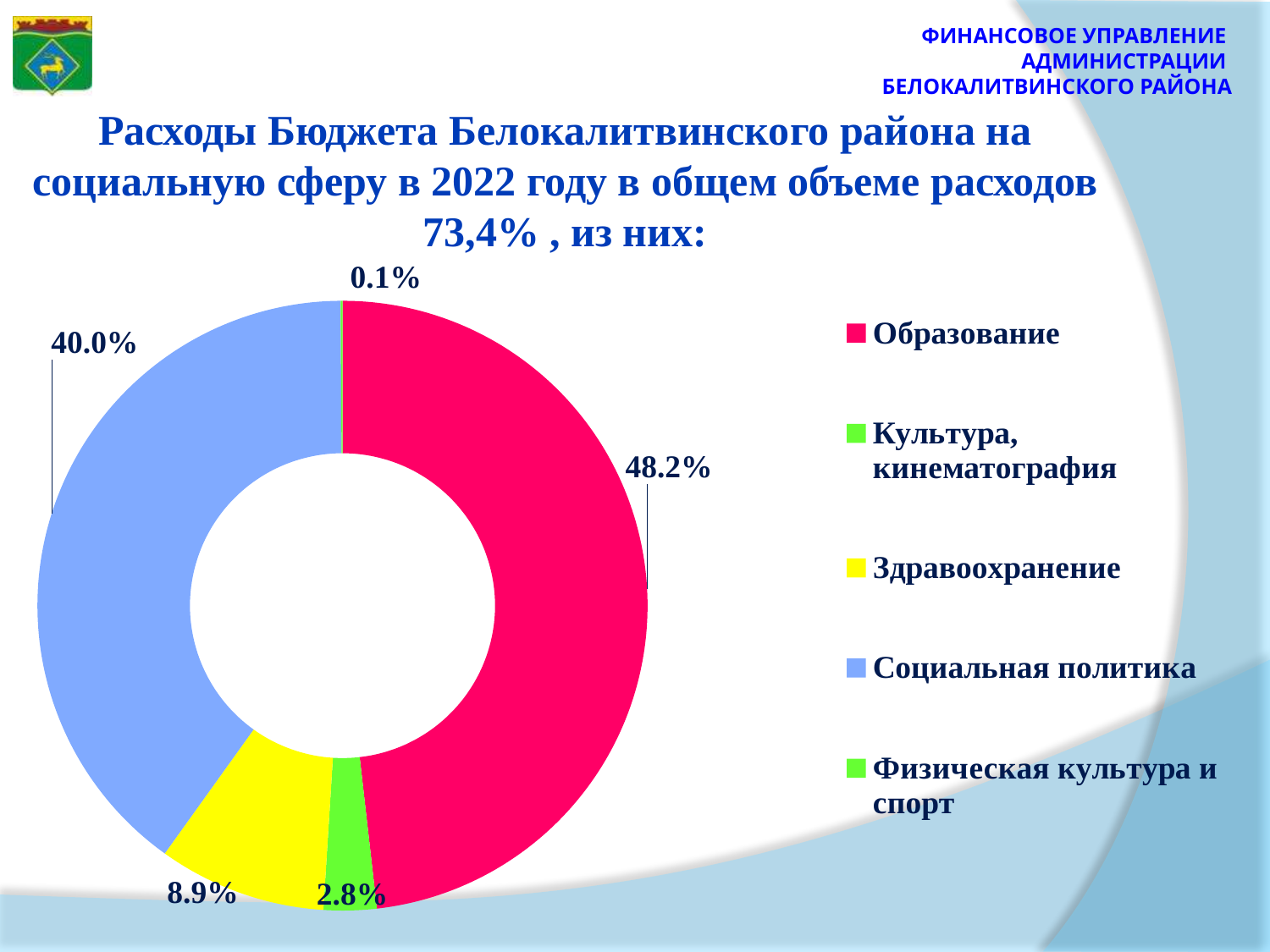
What is the difference in percentage points between Образование and Социальная политика? 8.2 Which category has the smallest share of the chart? Физическая культура и спорт Which is larger, the share for Здравоохранение or the share for Культура, кинематография? Здравоохранение What type of chart is shown on the slide? Pie (doughnut) chart What share of social-sphere expenditure goes to Социальная политика? 40.0% What share of social-sphere expenditure goes to Культура, кинематография? 2.8% What colour represents Социальная политика in the chart? Light blue What share of social-sphere expenditure goes to Физическая культура и спорт? 0.1% How many categories does the legend list? 5 What share of social-sphere expenditure goes to Образование? 48.2% What share of social-sphere expenditure goes to Здравоохранение? 8.9% Which category has the largest share of the chart? Образование